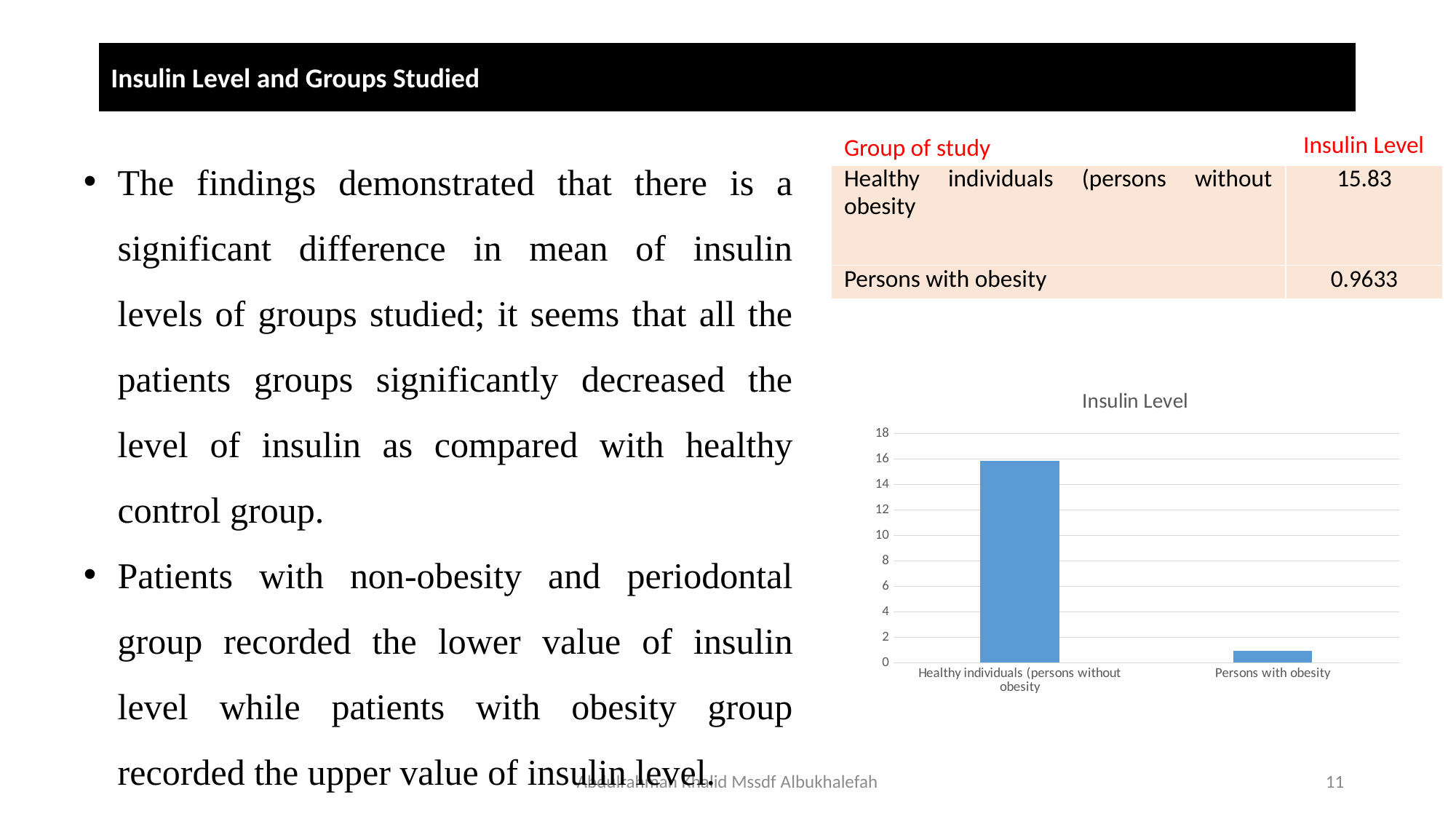
According to the table on the slide, what is the insulin level for Persons with obesity? 0.9633 What type of chart is shown on the slide? bar chart What is the title of the chart? Insulin Level What is the maximum value shown on the chart's vertical axis? 18 How many categories are plotted in the chart? 2 Which is larger, the insulin level for Healthy individuals (persons without obesity or for Persons with obesity? Healthy individuals (persons without obesity Which group has the lowest insulin level in the chart? Persons with obesity Is the insulin level for Healthy individuals (persons without obesity greater or less than 16? less According to the table on the slide, what is the insulin level for Healthy individuals (persons without obesity? 15.83 Which group has the highest insulin level in the chart? Healthy individuals (persons without obesity Is the insulin level for Persons with obesity greater or less than 2? less Is the insulin level for Healthy individuals (persons without obesity greater or less than 14? greater